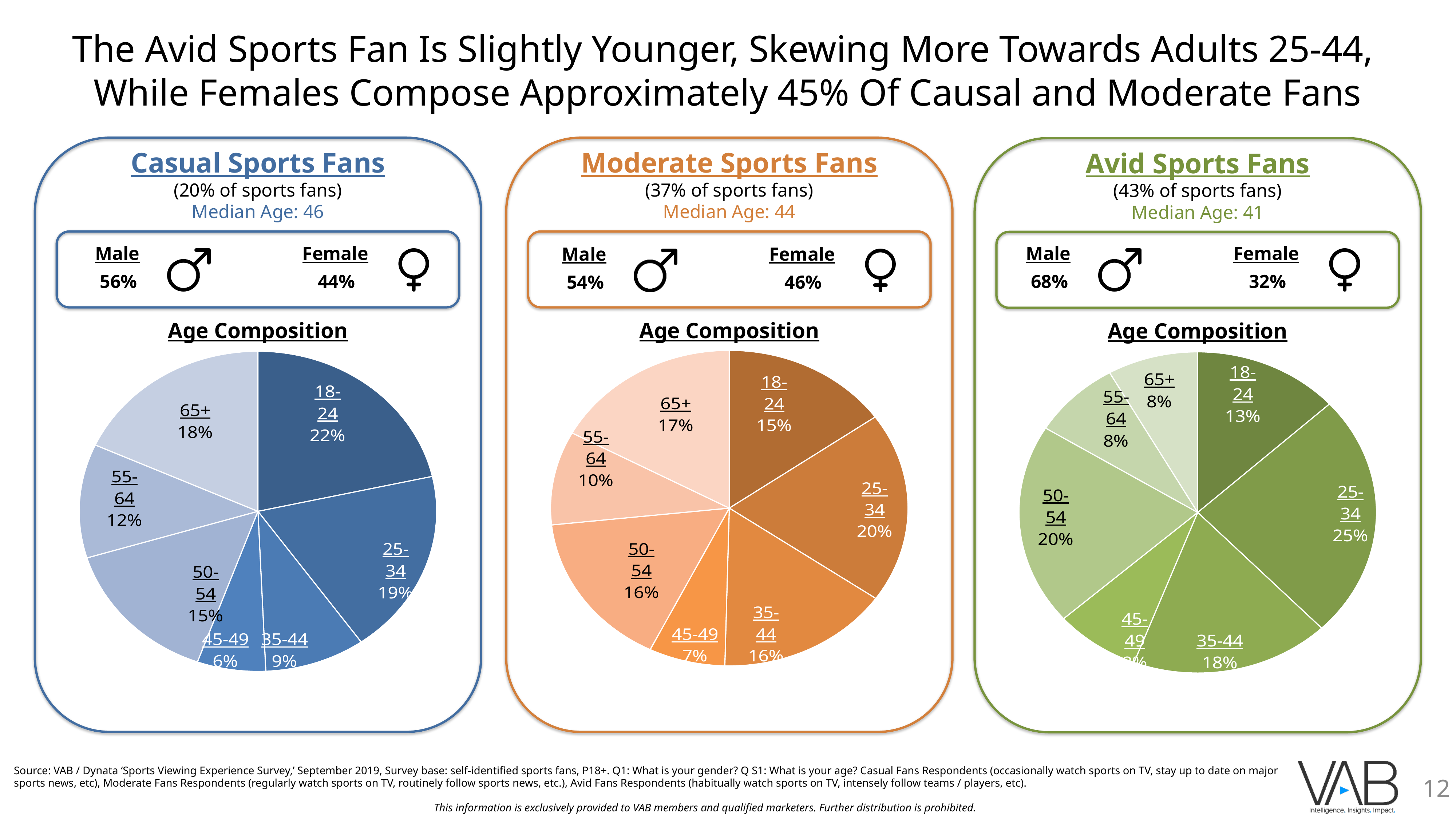
In the Moderate Sports Fans Age Composition chart, what share of fans are aged 65+? 17% How many age groups are shown in the Casual Sports Fans Age Composition chart? 7 What is the median age shown for Avid Sports Fans? 41 In the Casual Sports Fans Age Composition chart, what share of fans are aged 18-24? 22% In the Casual Sports Fans Age Composition chart, what is the difference between the 18-24 share and the 35-44 share? 13% In the Avid Sports Fans Age Composition chart, which is larger: the 35-44 share or the 18-24 share? 35-44 In the Avid Sports Fans Age Composition chart, which age group has the largest share? 25-34 In the Moderate Sports Fans Age Composition chart, which age group has the smallest share? 45-49 In the Avid Sports Fans Age Composition chart, what share of fans are aged 50-54? 20% In the Casual Sports Fans Age Composition chart, which age group has the smallest share? 45-49 What type of chart is used for the Age Composition in each fan segment? Pie chart In the Moderate Sports Fans Age Composition chart, which is larger: the 25-34 share or the 55-64 share? 25-34